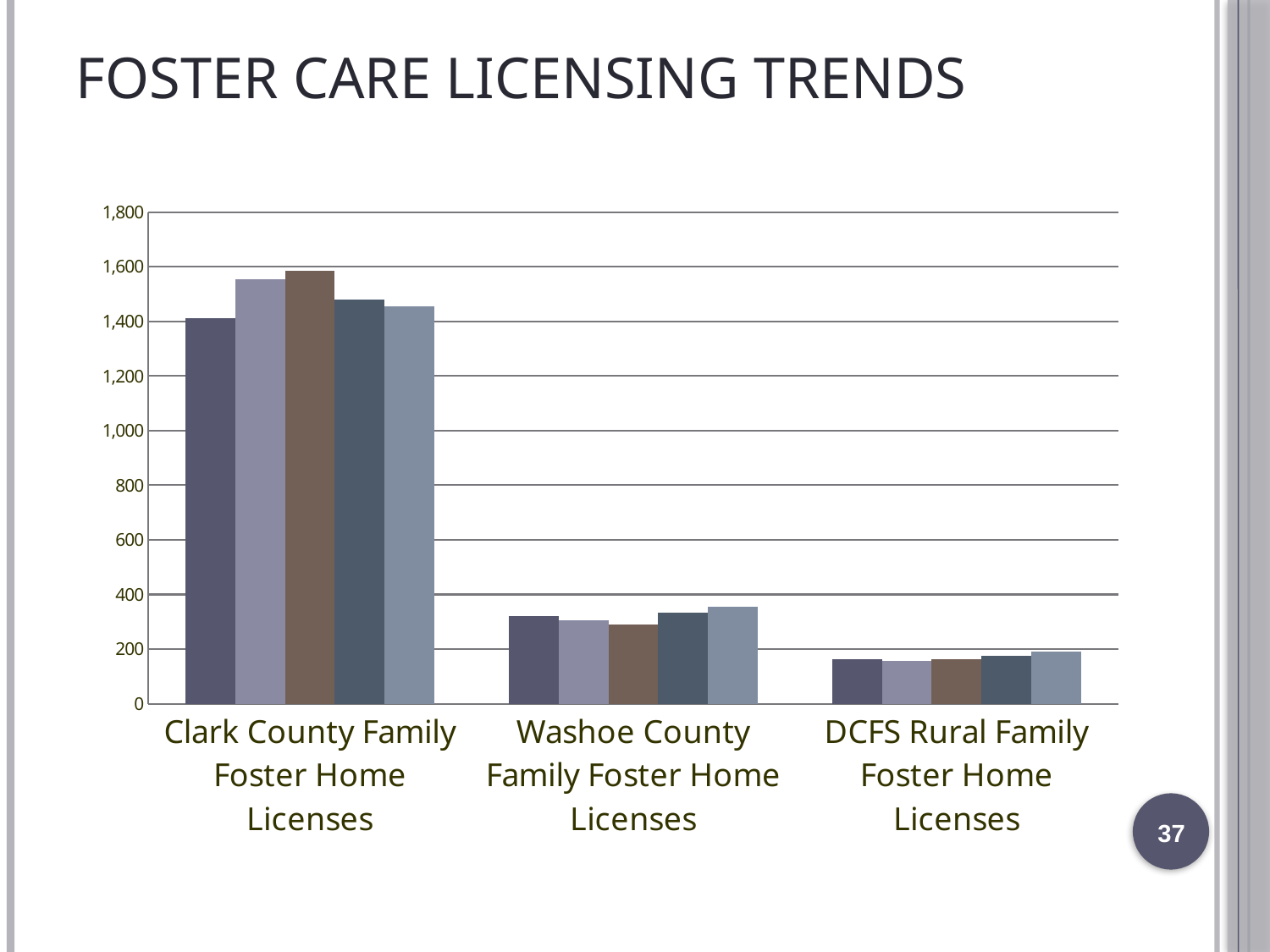
What kind of chart is shown on the slide? bar chart Are the values for DCFS Rural Family Foster Home Licenses greater or less than 400? less Do the values rise or fall moving from left to right across the categories on the x axis? fall Which category has the highest values in the chart? Clark County Family Foster Home Licenses Are the values for Washoe County Family Foster Home Licenses greater or less than 200? greater How many categories are shown on the x axis of the chart? 3 Are the values for Clark County Family Foster Home Licenses greater or less than 1,000? greater How many bars are plotted for each category in the chart? 5 What is the title of the slide containing the chart? Foster Care Licensing Trends Which category has the lowest values in the chart? DCFS Rural Family Foster Home Licenses Which has larger values, Washoe County Family Foster Home Licenses or DCFS Rural Family Foster Home Licenses? Washoe County Family Foster Home Licenses